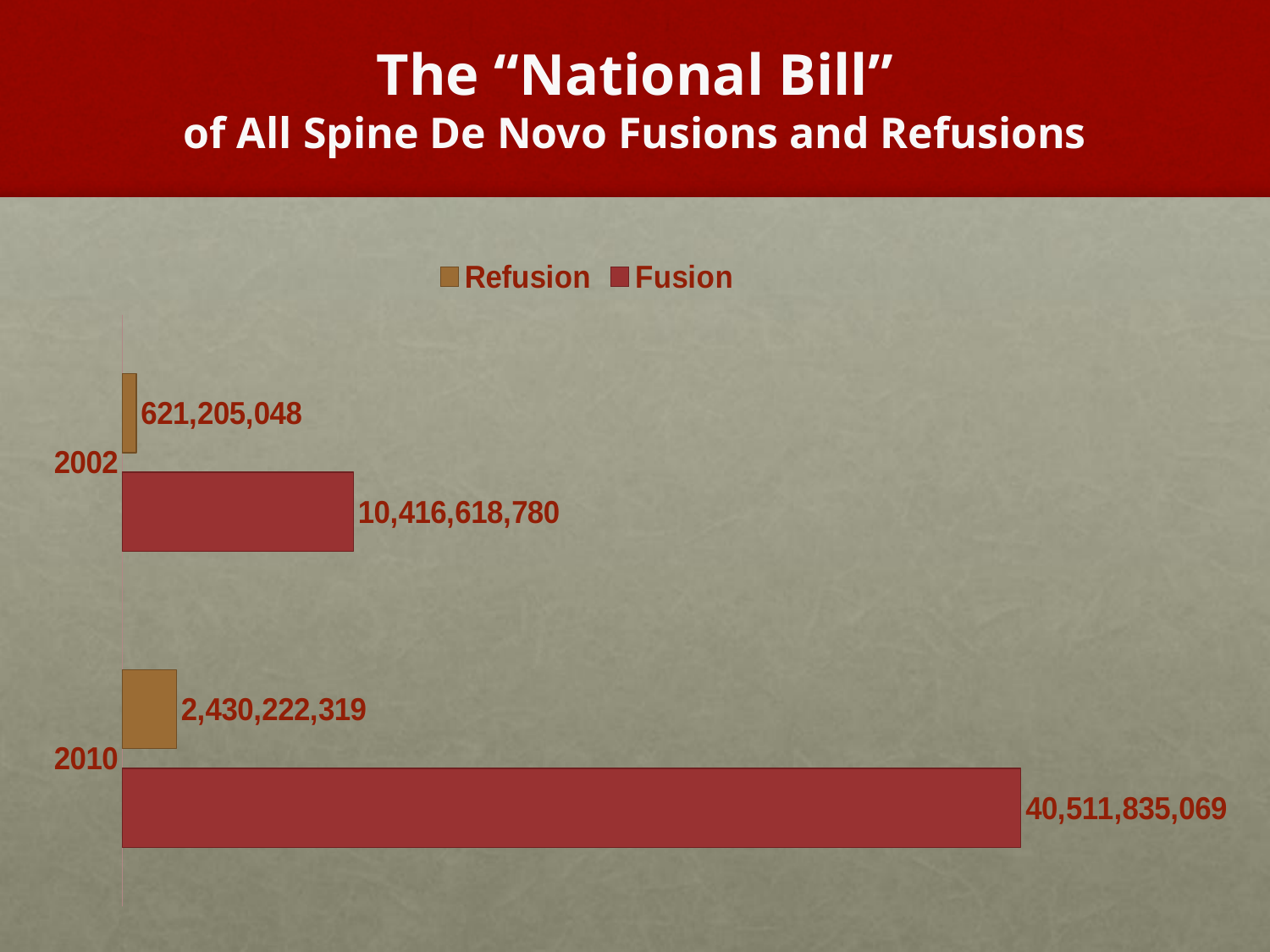
Which is larger in 2002, the Fusion value or the Refusion value? Fusion What is the Refusion value for 2002? 621,205,048 Which year has the highest Fusion value? 2010 How many series does the legend list? 2 What is the difference between the Fusion values for 2010 and 2002? 30,095,216,289 How many years are shown on the chart? 2 What kind of chart is shown on the slide? Bar chart What is the Refusion value for 2010? 2,430,222,319 What is the difference between the Fusion and Refusion values for 2010? 38,081,612,750 What is the Fusion value for 2002? 10,416,618,780 What is the Fusion value for 2010? 40,511,835,069 Which year has the lowest Refusion value? 2002